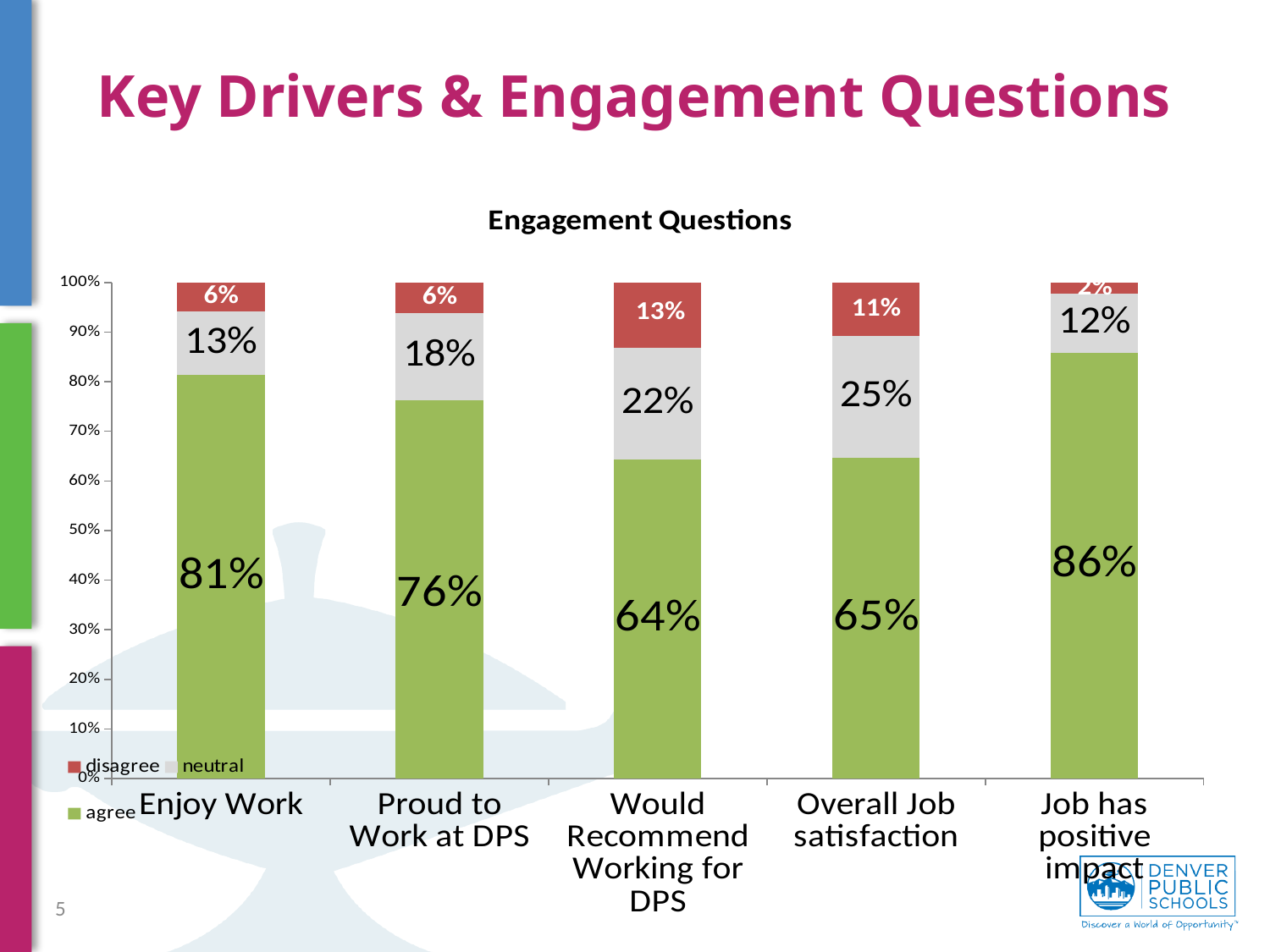
How many series does the legend list? 3 Which has a larger neutral percentage, "Proud to Work at DPS" or "Enjoy Work"? Proud to Work at DPS What is the disagree percentage for "Overall Job satisfaction"? 11% How many percentage points higher is the agree value for "Enjoy Work" than for "Proud to Work at DPS"? 5 percentage points What percentage of respondents agree with "Enjoy Work"? 81% What is the agree percentage for "Proud to Work at DPS"? 76% Is the agree value for "Overall Job satisfaction" greater or less than 70%? less What type of chart is shown on the slide? Stacked bar chart What is the neutral percentage for "Would Recommend Working for DPS"? 22% How many engagement questions are shown on the x axis? 5 Which engagement question has the lowest agree percentage? Would Recommend Working for DPS Which engagement question has the highest agree percentage? Job has positive impact